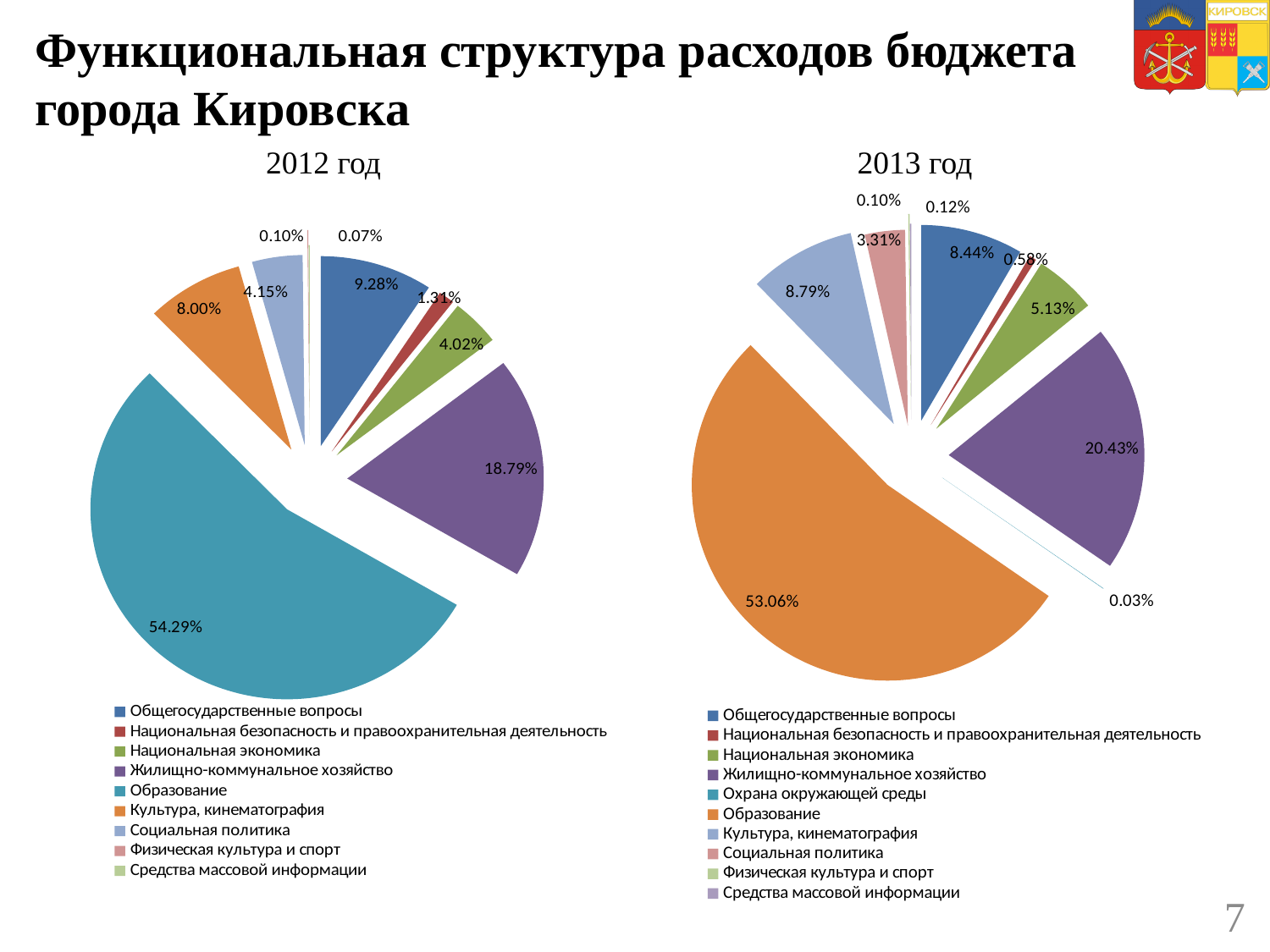
In the 2012 год pie chart, which category has the largest share? Образование In the 2012 год pie chart, which is larger: Культура, кинематография or Социальная политика? Культура, кинематография In the 2013 год pie chart, what share is shown for Жилищно-коммунальное хозяйство? 20.43% In the 2013 год pie chart, what share is shown for Образование? 53.06% In the 2012 год pie chart, what share is shown for Образование? 54.29% In the 2013 год pie chart, what share is shown for Охрана окружающей среды? 0.03% In the 2012 год pie chart, what share is shown for Жилищно-коммунальное хозяйство? 18.79% What is the difference between the share of Жилищно-коммунальное хозяйство in the 2013 год chart and in the 2012 год chart? 1.64% In the 2013 год pie chart, which category has the largest share? Образование How many categories does the legend of the 2013 год pie chart list? 10 In the 2013 год pie chart, what share is shown for Культура, кинематография? 8.79% What type of chart is used for the 2012 год data? Pie chart